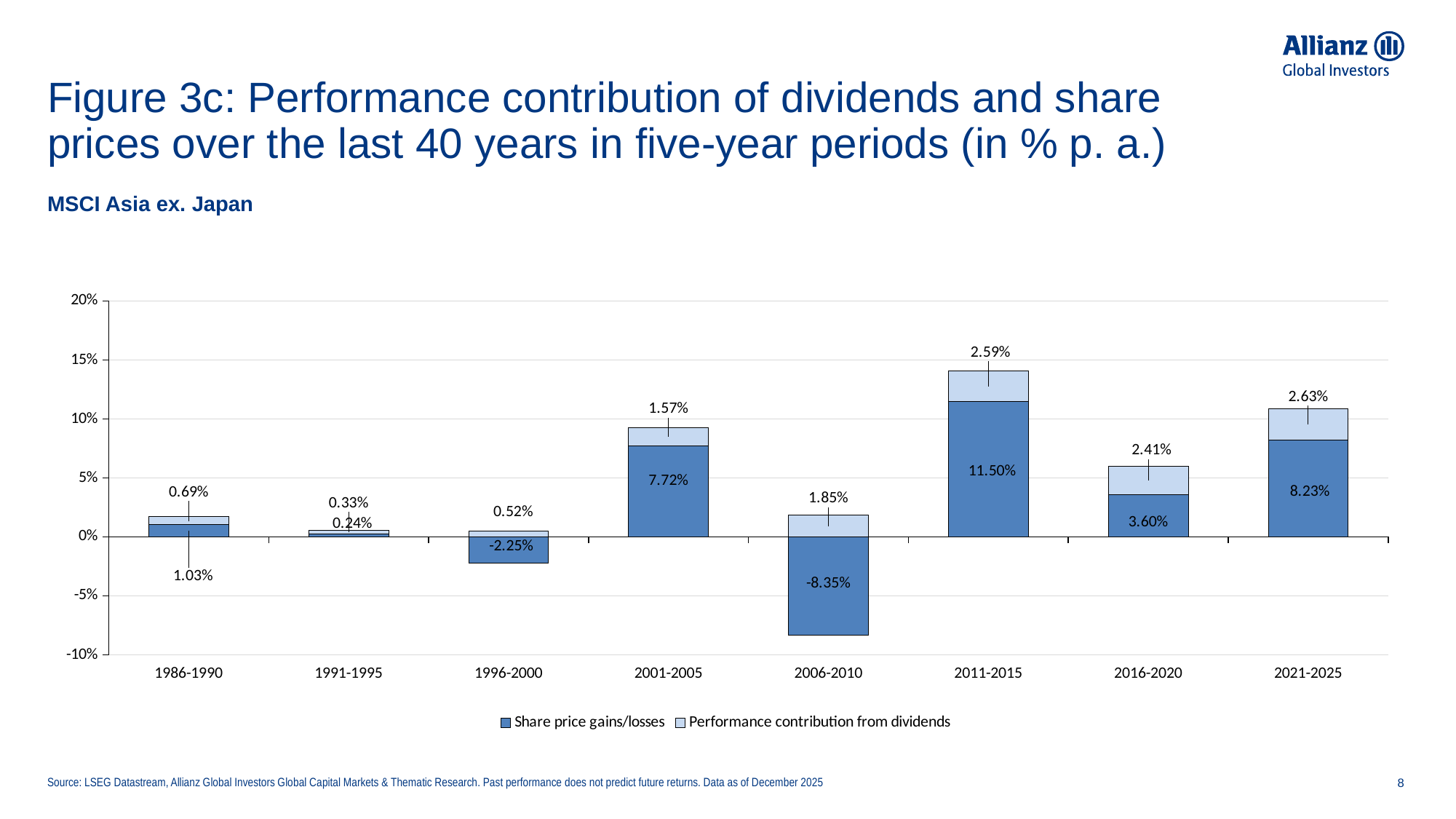
Which period has the lowest share price gains/losses value? 2006-2010 What is the share price gains/losses value for 1996-2000? -2.25% What is the total of the stacked bar for 2021-2025? 10.86% Which index does the chart cover, according to the subtitle? MSCI Asia ex. Japan Which period has the highest share price gains/losses value? 2011-2015 What is the difference between the share price gains/losses values for 2011-2015 and 2021-2025? 3.27% How many series does the legend list? 2 How many five-year periods are shown on the x axis? 8 What kind of chart is shown on the slide? Stacked bar chart What is the performance contribution from dividends for 2006-2010? 1.85% Which is larger, the performance contribution from dividends in 2016-2020 or in 2001-2005? 2016-2020 What is the share price gains/losses value for 2011-2015? 11.50%